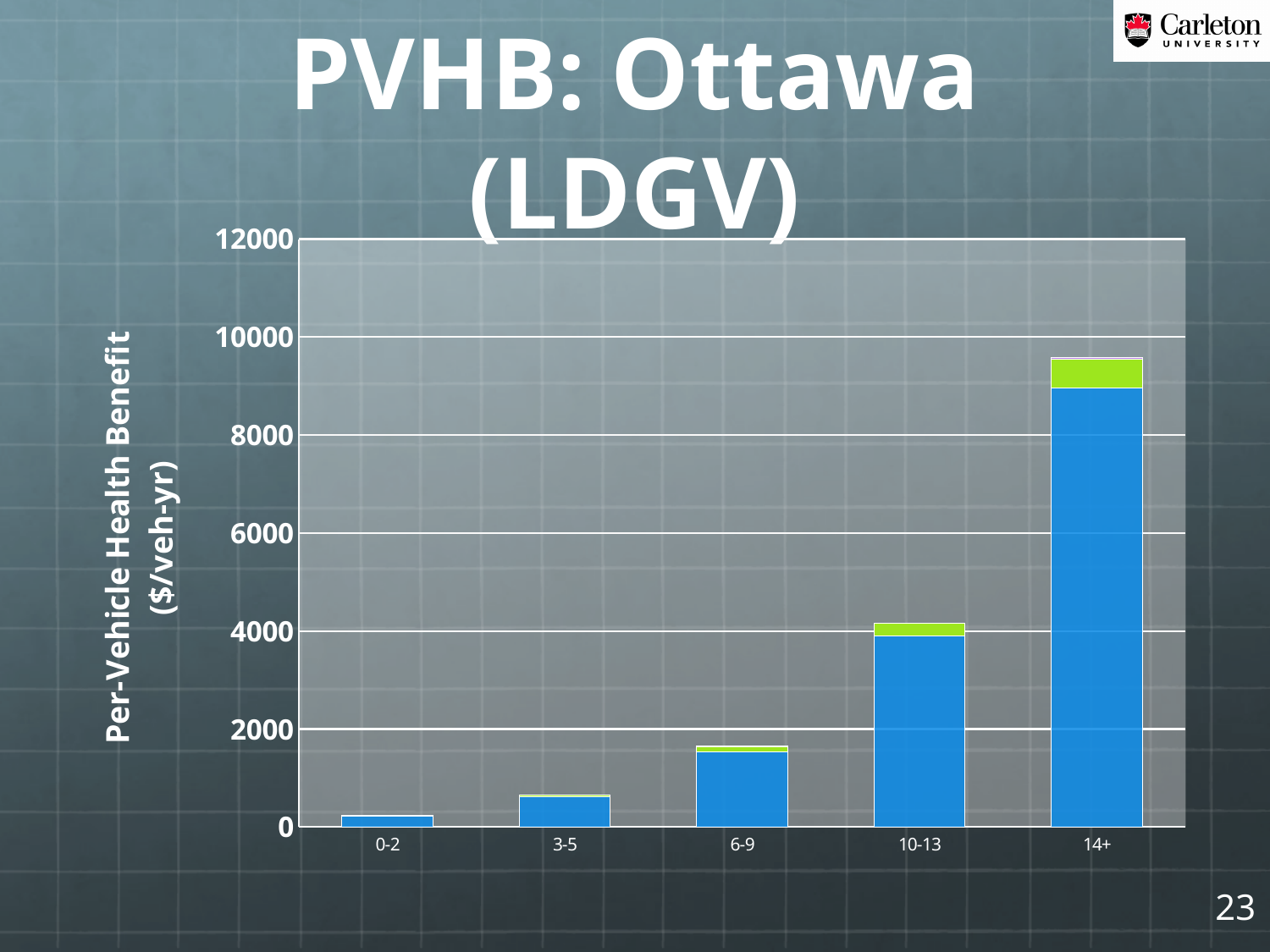
Which bar is taller, 14+ or 10-13? 14+ Do the bar heights rise or fall moving from 0-2 to 14+ along the x axis? rise Is the total value for 10-13 greater or less than 6000? less Is the total value for 6-9 greater or less than 2000? less Which bar is taller, 3-5 or 6-9? 6-9 Which category has the lowest bar in the chart? 0-2 Is the total value for 14+ greater or less than 8000? greater What is the label on the vertical axis of the chart? Per-Vehicle Health Benefit ($/veh-yr) What type of chart is shown on the slide? bar chart Which category has the highest bar in the chart? 14+ How many categories are shown on the x axis of the chart? 5